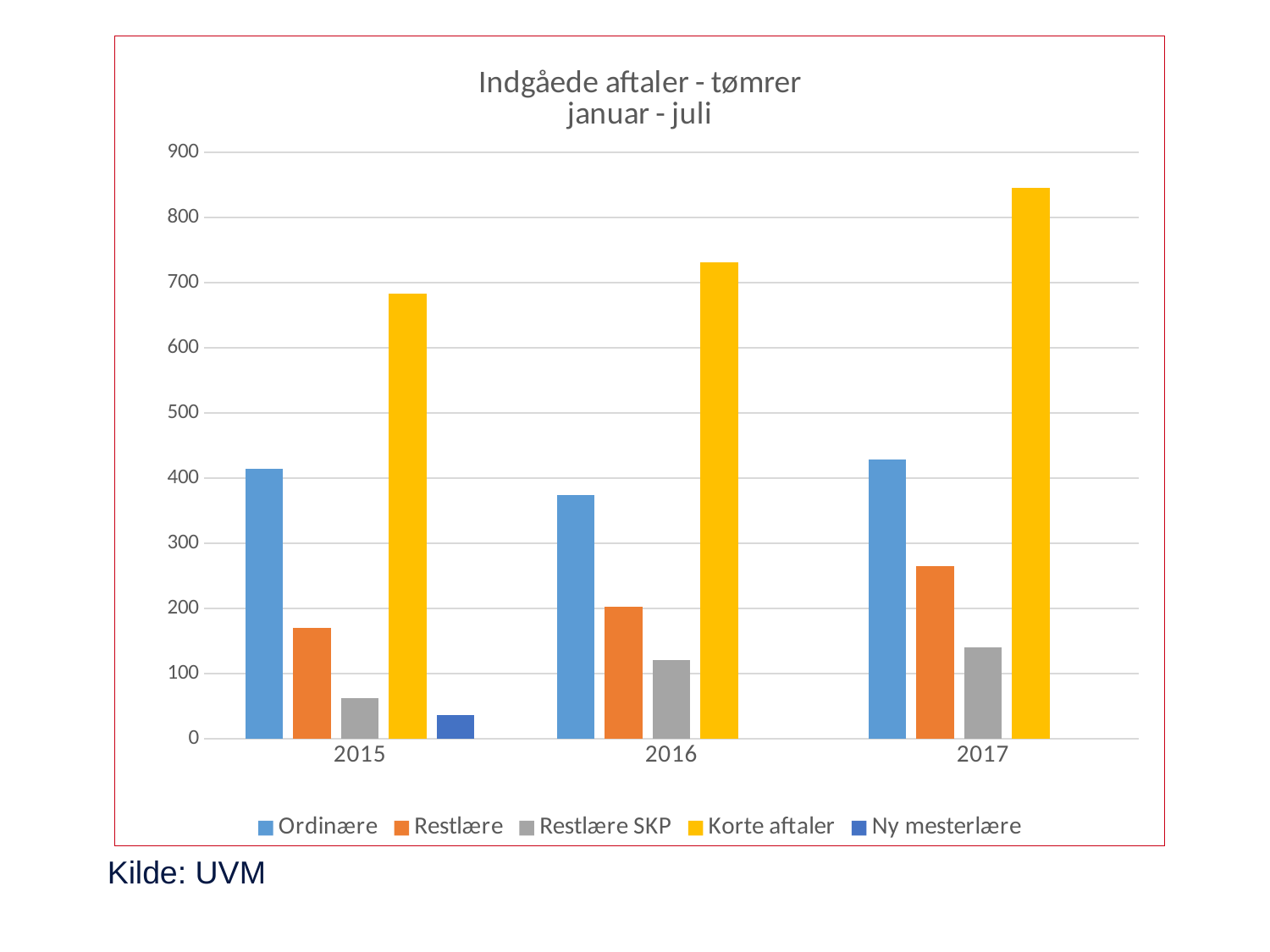
What kind of chart is shown on the slide? bar chart In which year is the value for Korte aftaler highest? 2017 How many series does the legend list? 5 Is the value for Restlære in 2017 greater or less than 200? greater What is the title of the chart? Indgåede aftaler - tømrer januar - juli Is the value for Ordinære in 2016 greater or less than 400? less Do the values for Korte aftaler rise or fall from 2015 to 2017? rise Is the value for Korte aftaler in 2017 greater or less than 800? greater Which is larger in 2016: Restlære or Restlære SKP? Restlære Which series has the lowest value in 2015? Ny mesterlære Which series has the highest value in 2017? Korte aftaler How many year categories are shown on the x axis? 3